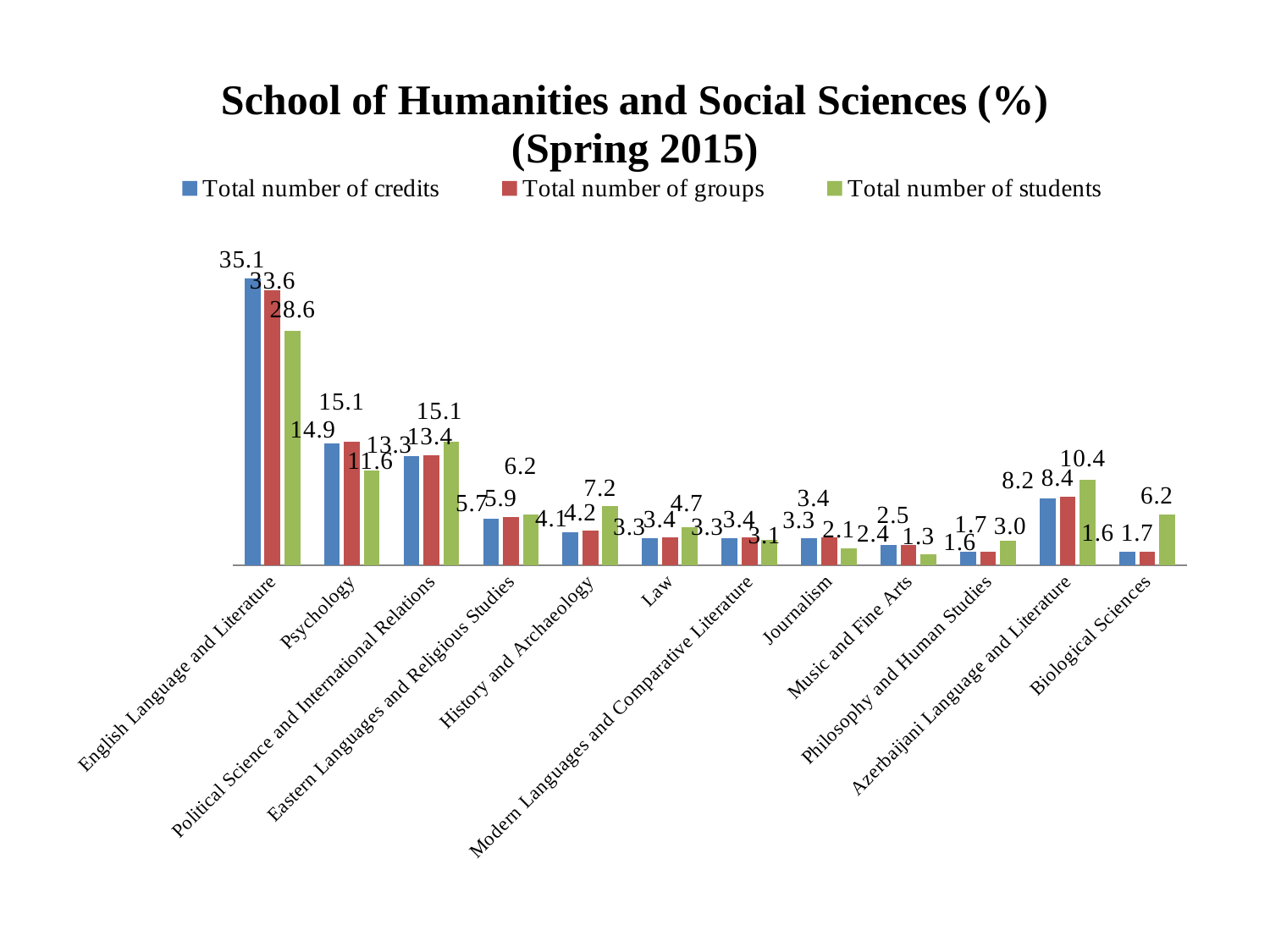
Which department has the lowest Total number of students value? Music and Fine Arts What is the difference between the Total number of credits and the Total number of students for English Language and Literature? 6.5 What is the difference between the Total number of students values for History and Archaeology and Law? 2.5 Which series is shown in green in the legend? Total number of students What is the Total number of students value for Azerbaijani Language and Literature? 10.4 What type of chart is shown on the slide? bar chart What is the Total number of credits value for English Language and Literature? 35.1 Which department has the highest Total number of students value? English Language and Literature How many series does the legend list? 3 What is the Total number of groups value for Psychology? 15.1 Which is larger for Biological Sciences: Total number of students or Total number of credits? Total number of students How many departments (categories) are shown on the x axis? 12